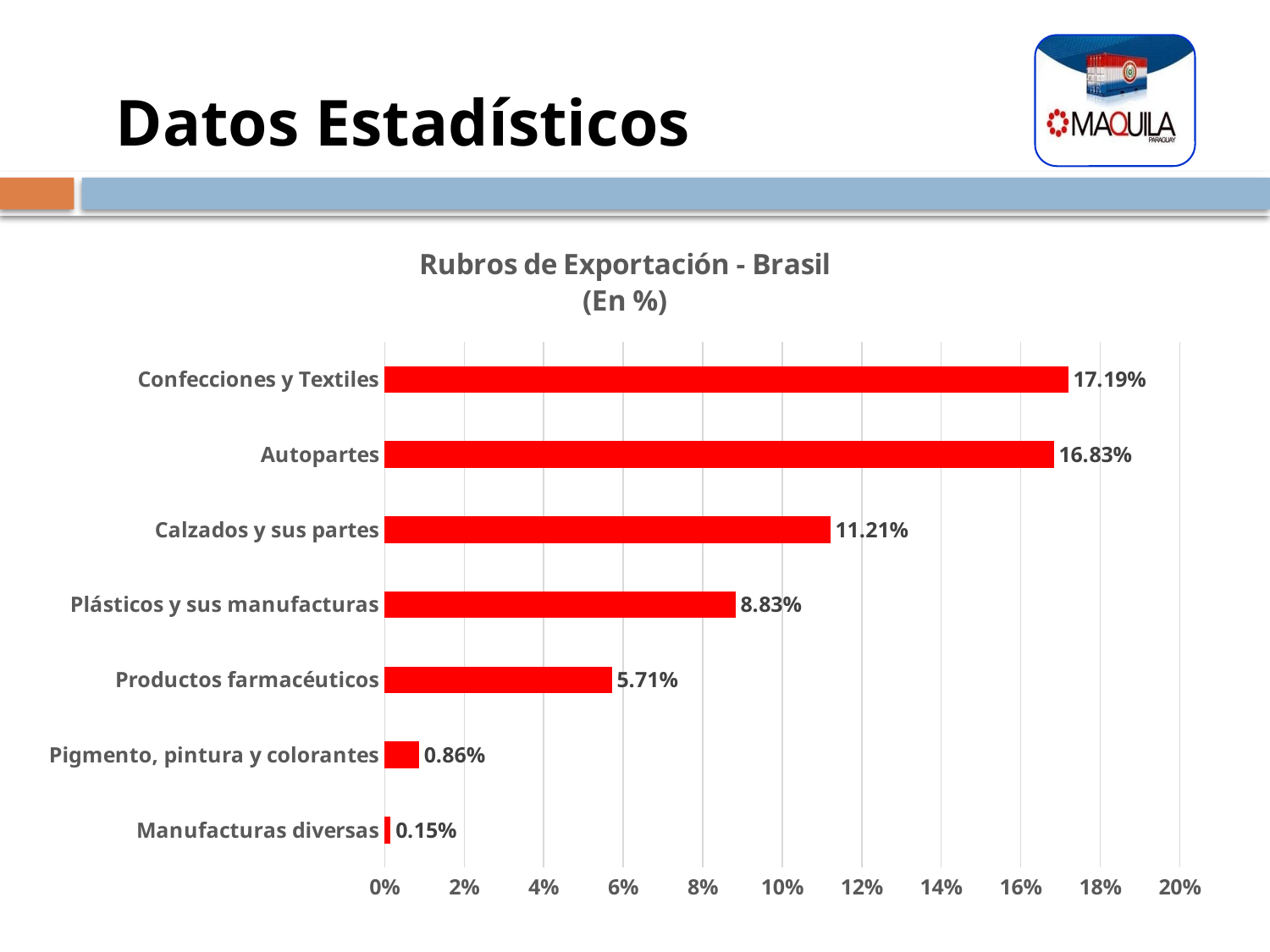
Is the value for Autopartes greater or less than 16%? greater Which category has the lowest value? Manufacturas diversas Which is larger, the value for Plásticos y sus manufacturas or the value for Productos farmacéuticos? Plásticos y sus manufacturas How many categories are shown in the chart? 7 What is the difference between the values for Confecciones y Textiles and Autopartes? 0.36% What is the value for Calzados y sus partes? 11.21% What is the value for Productos farmacéuticos? 5.71% Which category has the highest value? Confecciones y Textiles What is the title of the chart? Rubros de Exportación - Brasil (En %) What kind of chart is shown on the slide? Bar chart What is the difference between the values for Calzados y sus partes and Plásticos y sus manufacturas? 2.38% What is the value for Confecciones y Textiles? 17.19%